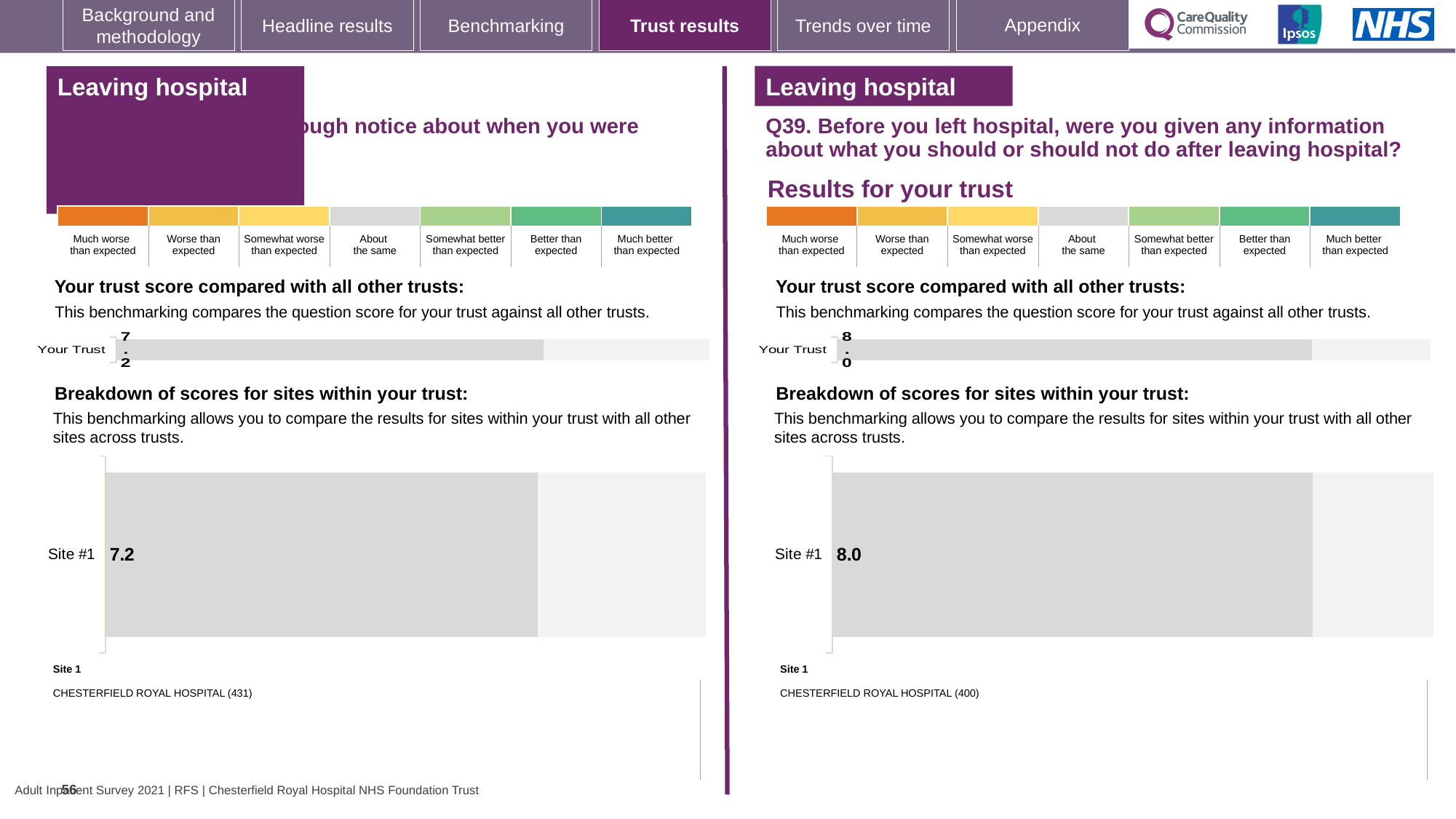
How many categories are plotted on the left-hand 'Your trust score compared with all other trusts' chart? 1 What is the difference between the Site #1 value on the right-hand Q39 breakdown chart and the Site #1 value on the left-hand breakdown chart? 0.8 On the left-hand 'Your trust score compared with all other trusts' chart, what is the value shown for Your Trust? 7.2 On the left-hand 'Breakdown of scores for sites within your trust' chart, what is the value shown for Site #1? 7.2 Is the Your Trust value on the right-hand Q39 chart the same as the Site #1 value on the right-hand Q39 breakdown chart? yes Which site is listed as Site 1 beneath the left-hand breakdown chart? CHESTERFIELD ROYAL HOSPITAL (431) Is the Site #1 value on the right-hand Q39 breakdown chart larger or smaller than the Site #1 value on the left-hand breakdown chart? larger Which site is listed as Site 1 beneath the right-hand Q39 breakdown chart? CHESTERFIELD ROYAL HOSPITAL (400) On the right-hand 'Results for your trust' chart for Q39, what is the value shown for Your Trust? 8.0 On the right-hand 'Breakdown of scores for sites within your trust' chart for Q39, what is the value shown for Site #1? 8.0 How many sites are plotted on the right-hand Q39 'Breakdown of scores for sites within your trust' chart? 1 What type of chart is used to show the Site #1 score on the right-hand Q39 breakdown chart? bar chart